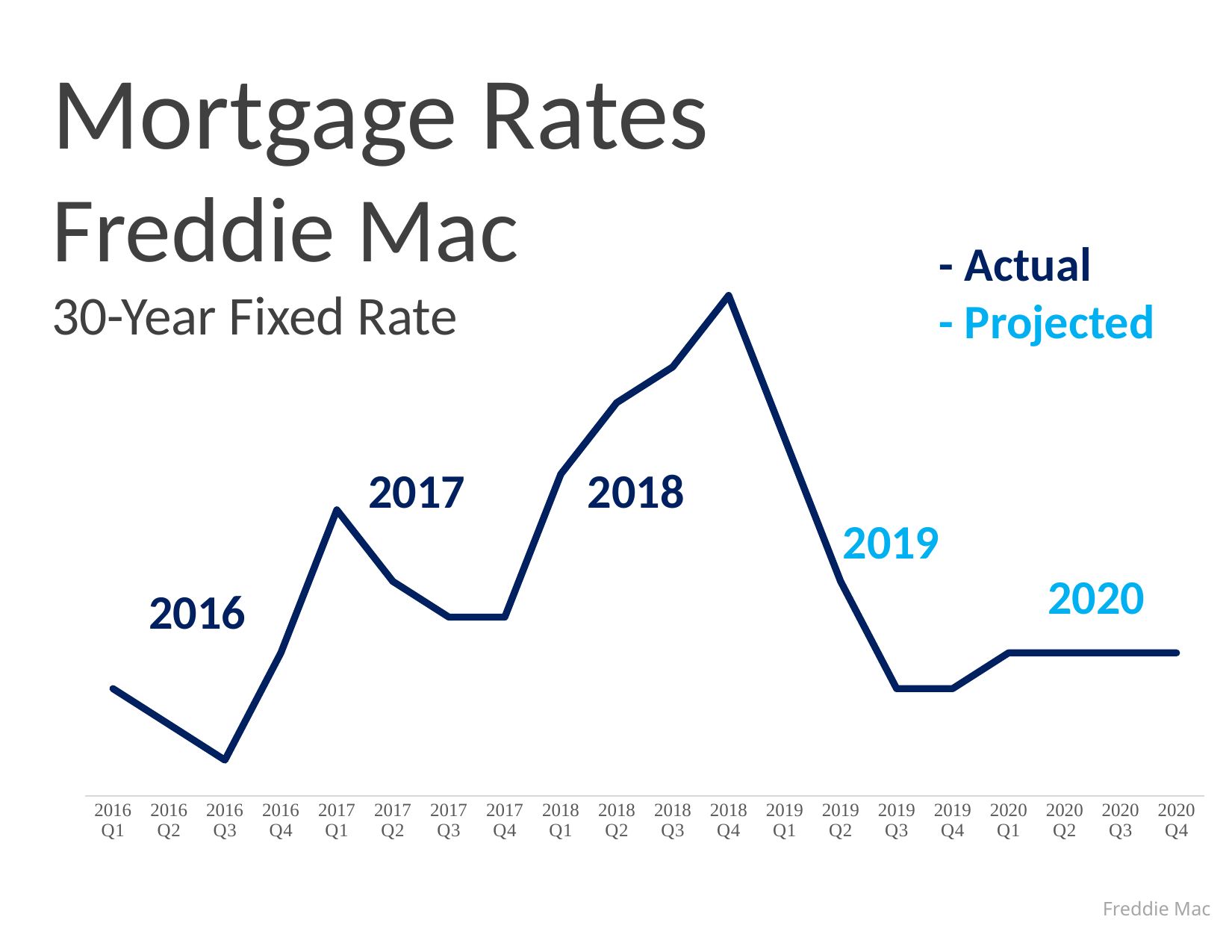
Does the mortgage rate rise or fall from 2018 Q4 to 2019 Q3? fall How many quarterly points are plotted along the x axis? 20 Which is higher, the rate in 2018 Q4 or the rate in 2019 Q3? 2018 Q4 Does the mortgage rate rise or fall from 2016 Q3 to 2017 Q1? rise What kind of chart is shown on the slide? line chart In which quarter does the mortgage rate reach its highest point? 2018 Q4 Which years on the chart are labelled as projected rather than actual? 2019 and 2020 Which is higher, the rate in 2017 Q1 or the rate in 2016 Q1? 2017 Q1 Which is higher, the rate in 2020 Q1 or the rate in 2019 Q4? 2020 Q1 How many entries does the legend list? 2 Does the mortgage rate rise or fall from 2018 Q1 to 2018 Q4? rise In which quarter does the mortgage rate reach its lowest point? 2016 Q3